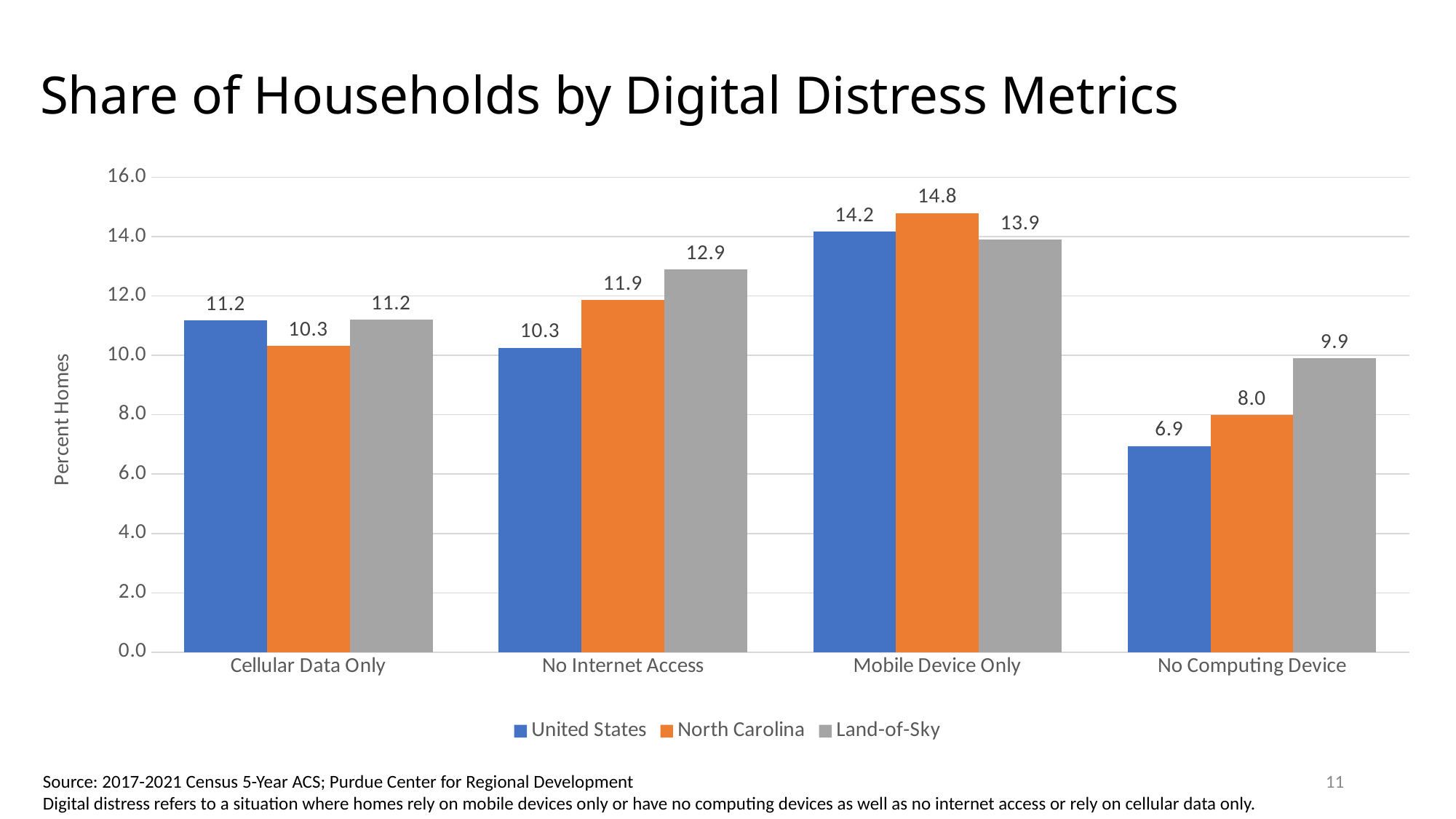
What is the difference between the Land-of-Sky and United States values in the No Computing Device category? 3.0 How many series does the legend list? 3 Which category has the lowest value for the North Carolina series? No Computing Device What kind of chart is shown on the slide? Bar chart Is the value for North Carolina in the Cellular Data Only category greater or less than 12.0? less How many categories are shown on the x axis? 4 What is the value for North Carolina in the Mobile Device Only category? 14.8 What is the value for the United States in the No Computing Device category? 6.9 Which category has the highest value for the United States series? Mobile Device Only In the No Internet Access category, which is larger: the North Carolina value or the Land-of-Sky value? Land-of-Sky What is the value for Land-of-Sky in the No Internet Access category? 12.9 What is the label of the y axis? Percent Homes